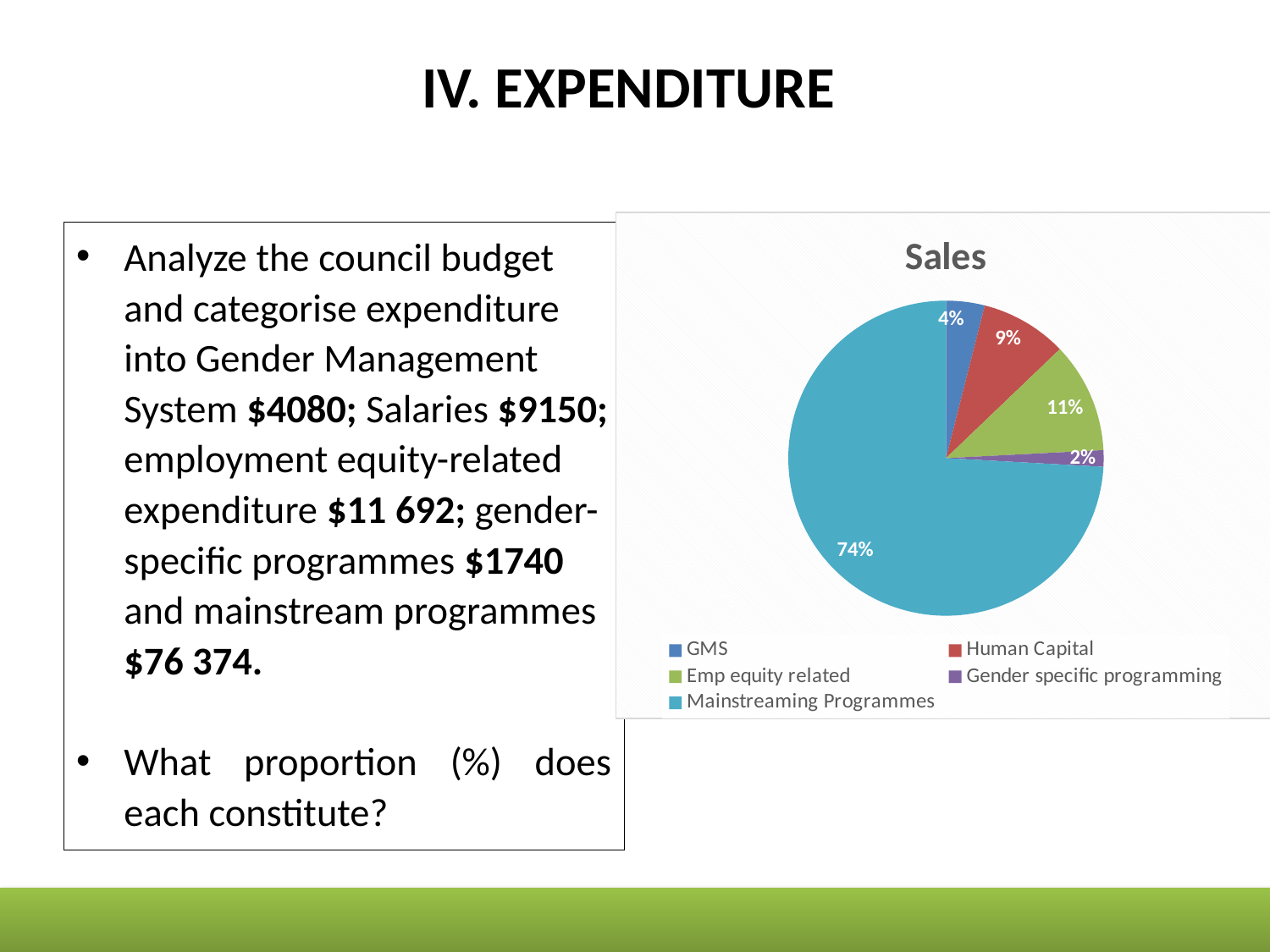
Which category has the smallest slice of the pie? Gender specific programming What kind of chart is shown on the slide? pie chart How many entries does the chart legend list? 5 What share of the pie does Gender specific programming represent? 2% What share of the pie does GMS represent? 4% What share of the pie does Mainstreaming Programmes represent? 74% What is the difference in percentage points between the Emp equity related slice and the Human Capital slice? 2% Which category has the largest slice of the pie? Mainstreaming Programmes What is the title of the chart? Sales How many slices does the pie chart have? 5